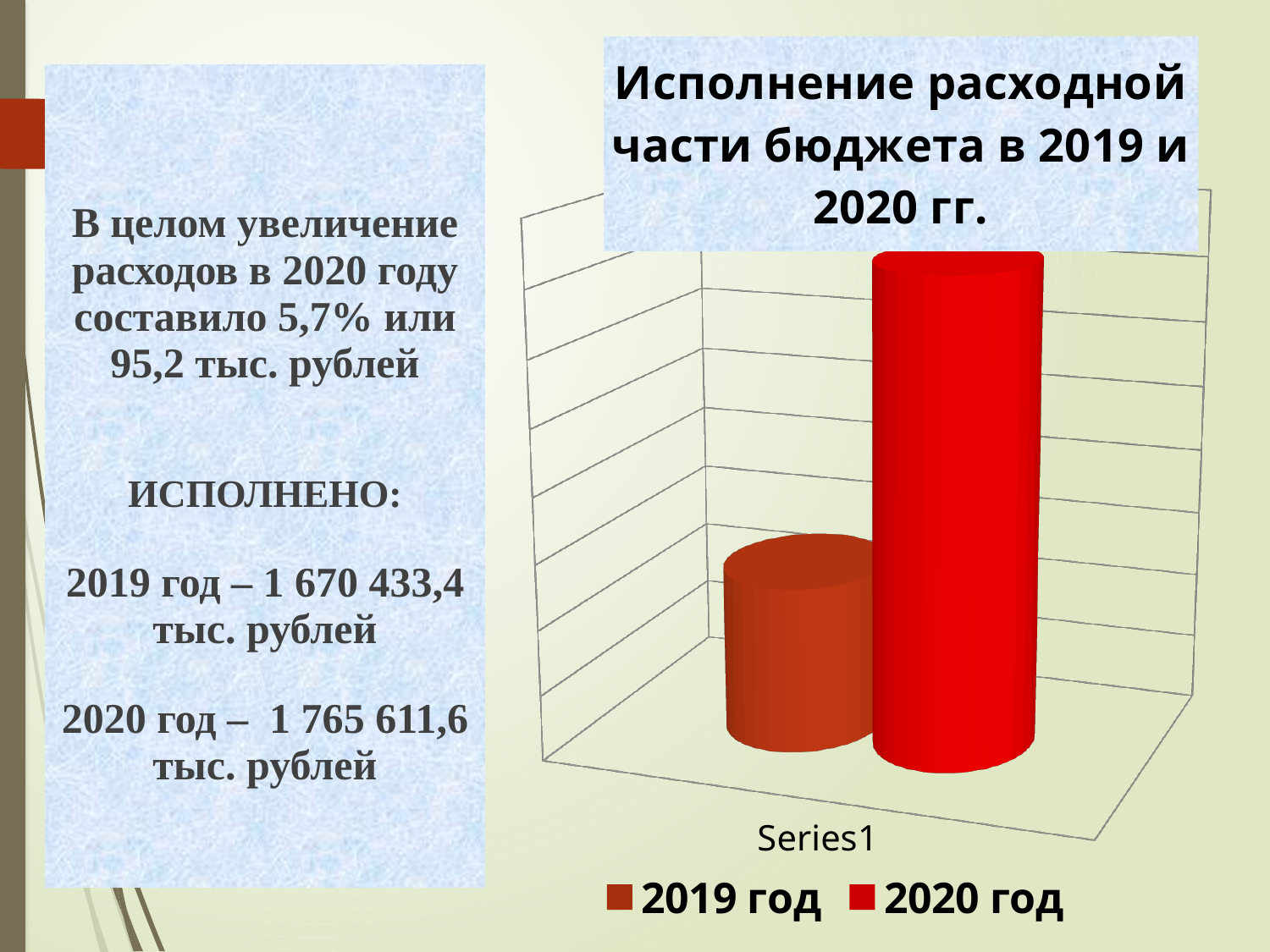
What is the title of the chart? Исполнение расходной части бюджета в 2019 и 2020 гг. What kind of chart is shown on the slide? bar chart Which series has the shorter bar in the chart? 2019 год What is the label of the category on the chart's horizontal axis? Series1 How many categories are shown on the chart's horizontal axis? 1 Which series has the taller bar in the chart? 2020 год Do the bars rise or fall from 2019 год to 2020 год? rise How many series does the chart legend list? 2 Is the bar for 2020 год taller or shorter than the bar for 2019 год? taller Which series are listed in the chart legend? 2019 год, 2020 год